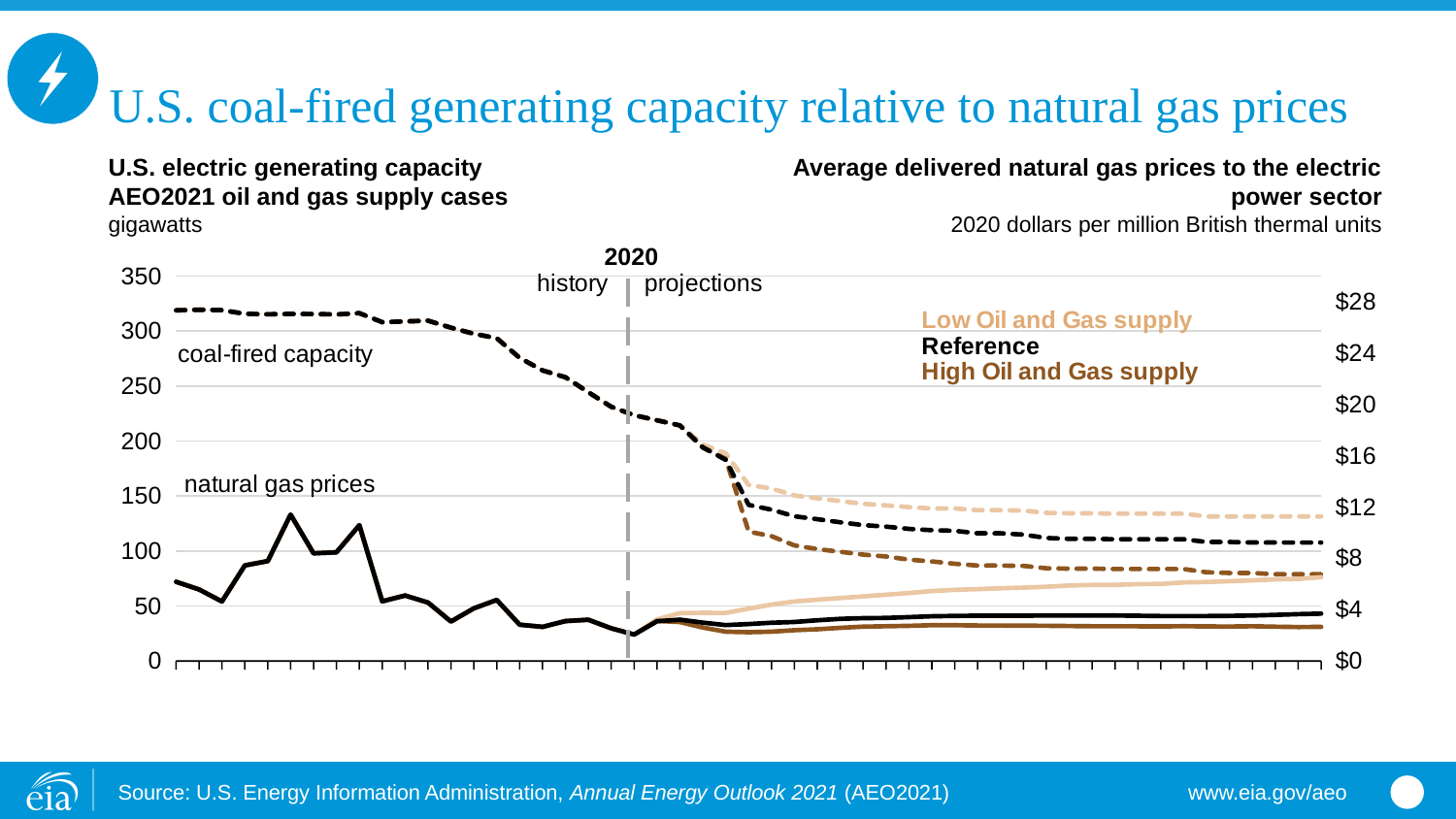
Which year marks the boundary between history and projections on the chart? 2020 Which oil and gas supply case has the highest coal-fired capacity at the end of the projection period? Low Oil and Gas supply Which oil and gas supply case has the lowest projected natural gas prices? High Oil and Gas supply Which oil and gas supply case has the lowest coal-fired capacity at the end of the projection period? High Oil and Gas supply Does coal-fired capacity rise or fall over the projection period? fall Is the Reference case coal-fired capacity at the end of the projection period greater or less than 150 gigawatts? less Is coal-fired capacity at the start of the history period greater or less than 300 gigawatts? greater How many oil and gas supply cases does the legend list? 3 At the end of the projection period, is coal-fired capacity higher in the Reference case or the High Oil and Gas supply case? Reference Do natural gas prices in the Low Oil and Gas supply case rise or fall over the projection period? rise What kind of chart is shown on the slide? line chart Is the Low Oil and Gas supply natural gas price at the end of the projection period greater or less than $4? greater